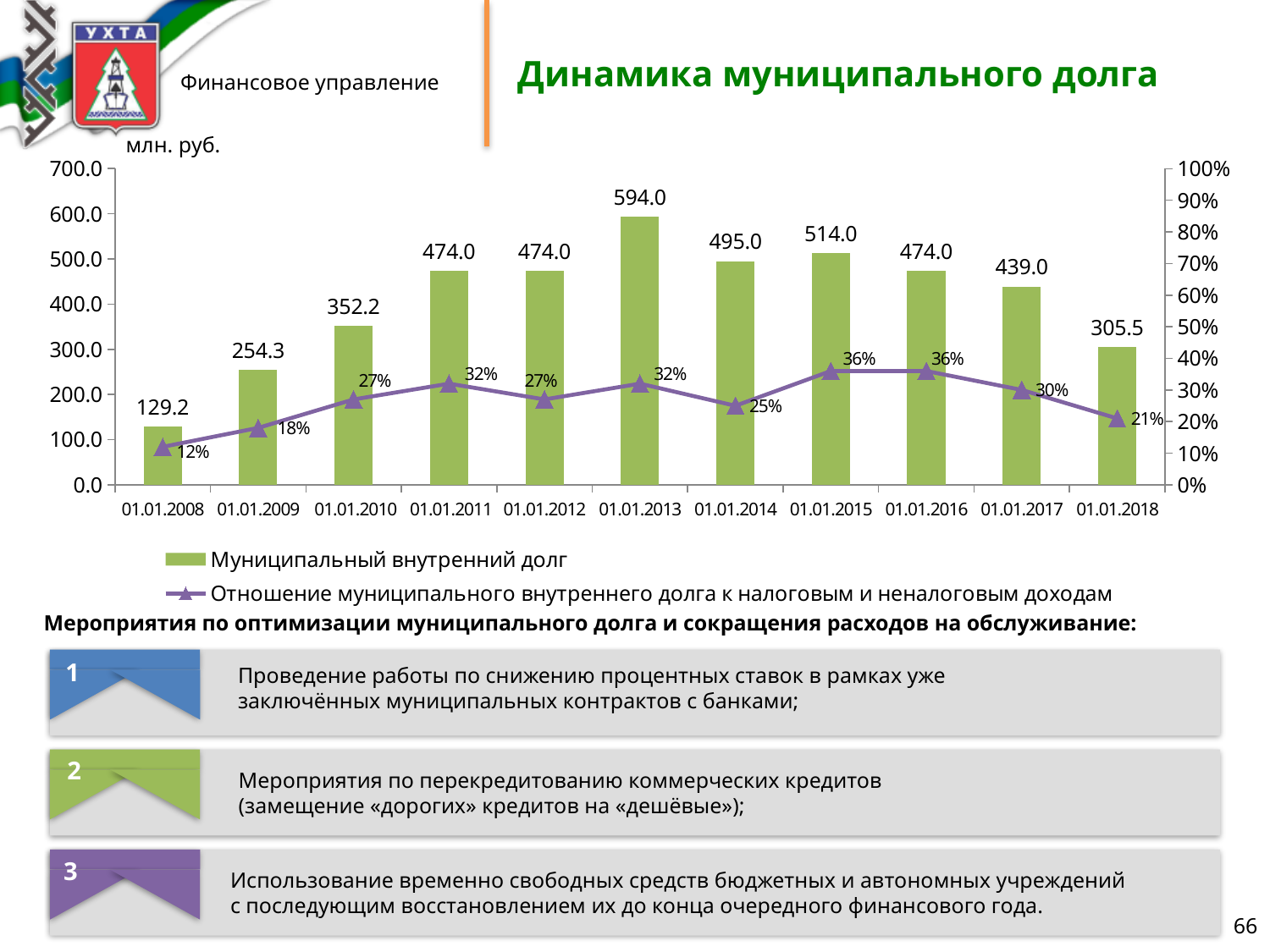
Which is larger: Муниципальный внутренний долг on 01.01.2010 or on 01.01.2018? 01.01.2010 On which date is Муниципальный внутренний долг lowest? 01.01.2008 What kind of chart is used to show Муниципальный внутренний долг? bar chart How many series does the legend list? 2 What is the value of Муниципальный внутренний долг on 01.01.2018? 305.5 What is the value of Отношение муниципального внутреннего долга к налоговым и неналоговым доходам on 01.01.2017? 30% What is the difference between Муниципальный внутренний долг on 01.01.2015 and on 01.01.2014? 19.0 What is the value of Муниципальный внутренний долг on 01.01.2013? 594.0 What is the title of the chart? Динамика муниципального долга On which date is Муниципальный внутренний долг highest? 01.01.2013 How many dates are shown on the x axis of the chart? 11 What is the value of Муниципальный внутренний долг on 01.01.2008? 129.2